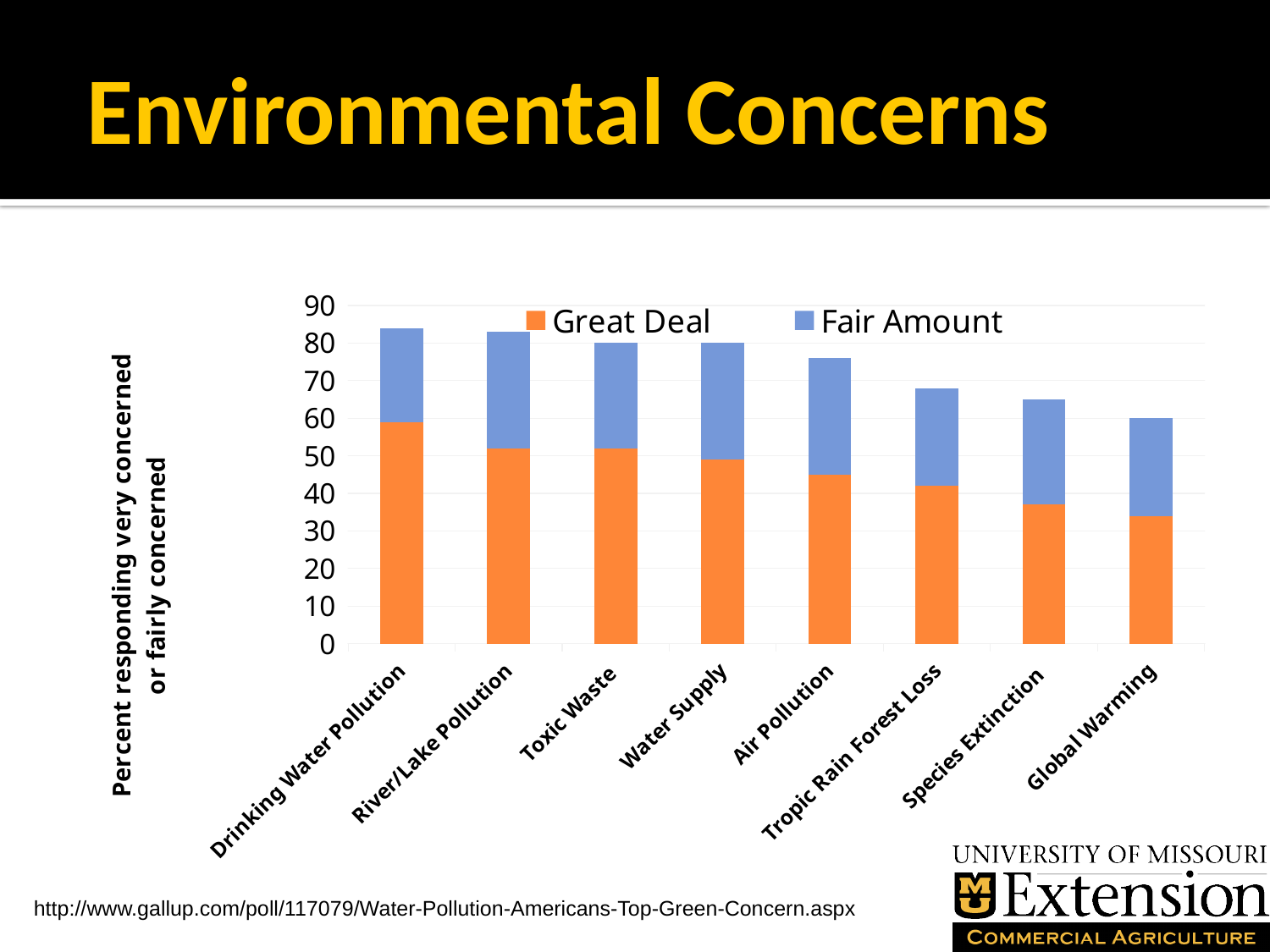
Is the total bar height for Air Pollution greater or less than 70? greater Do the total bar heights rise or fall moving from left to right along the x axis? fall Which category has the lowest total bar height? Global Warming Is the total bar height for Global Warming greater or less than 70? less Is the 'Great Deal' value for Species Extinction greater or less than 40? less How many series does the legend list? 2 Which has the larger 'Great Deal' value, Air Pollution or Species Extinction? Air Pollution Which colour represents the 'Fair Amount' series in the legend? Blue Which category has the highest 'Great Deal' value? Drinking Water Pollution How many environmental concern categories are shown on the x axis? 8 What kind of chart is shown on the slide? Stacked bar chart